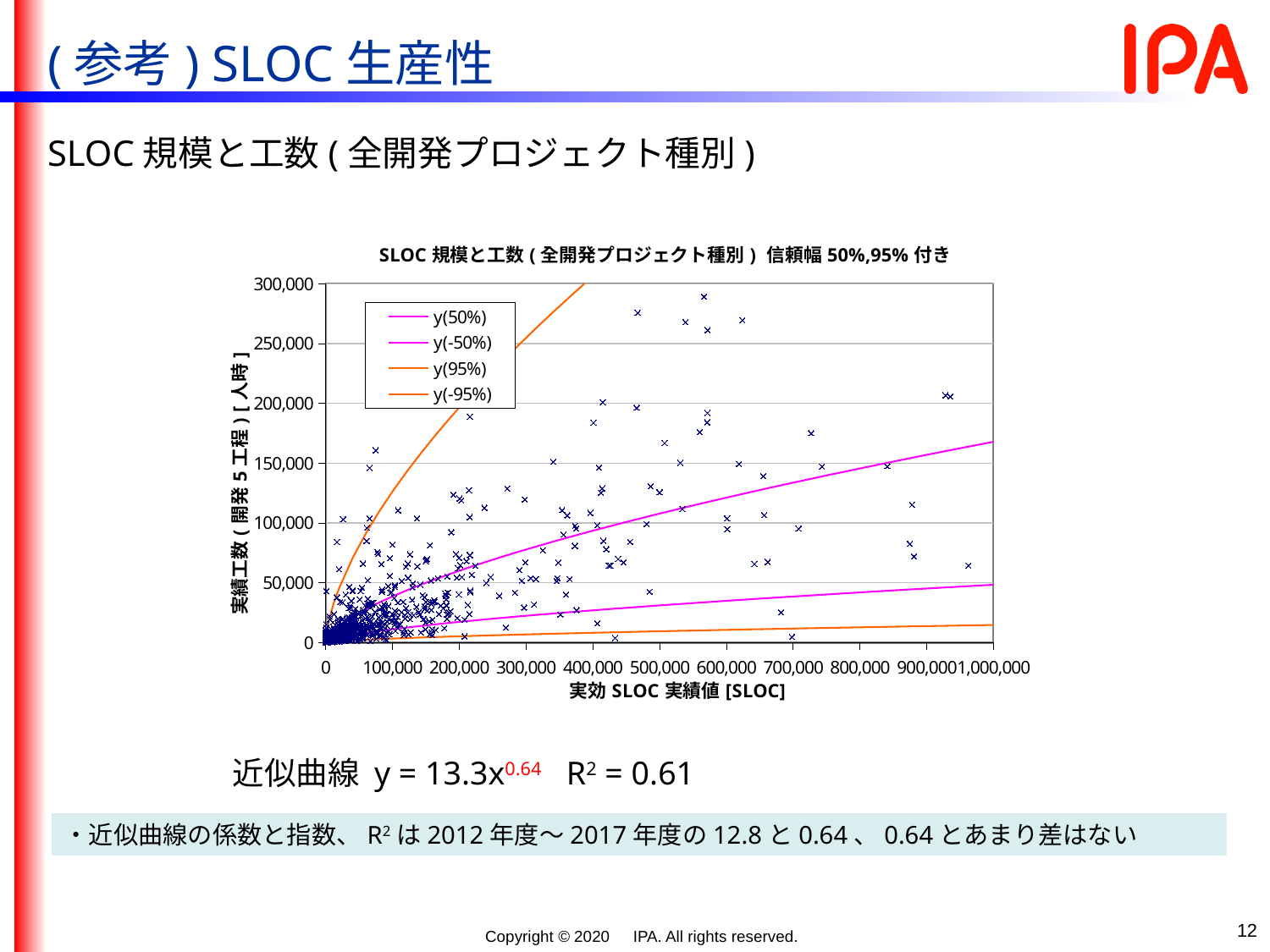
What kind of chart is shown on the slide? scatter chart What is the title of the chart? SLOC 規模と工数 ( 全開発プロジェクト種別 ) 信頼幅 50%,95% 付き At x = 1,000,000, is the value of the y(-95%) line greater or less than 50,000? less At x = 1,000,000, is the value of the y(50%) line greater or less than 150,000? greater How many series does the chart legend list? 4 What is the maximum value shown on the y axis of the chart? 300,000 At x = 1,000,000, is the value of the y(50%) line greater or less than 200,000? less What is the maximum value shown on the x axis of the chart? 1,000,000 Does the y(50%) line rise or fall as the x axis value increases? rises What is the label of the x axis of the chart? 実効 SLOC 実績値 [SLOC] At x = 1,000,000, which line is higher, y(50%) or y(-50%)? y(50%)